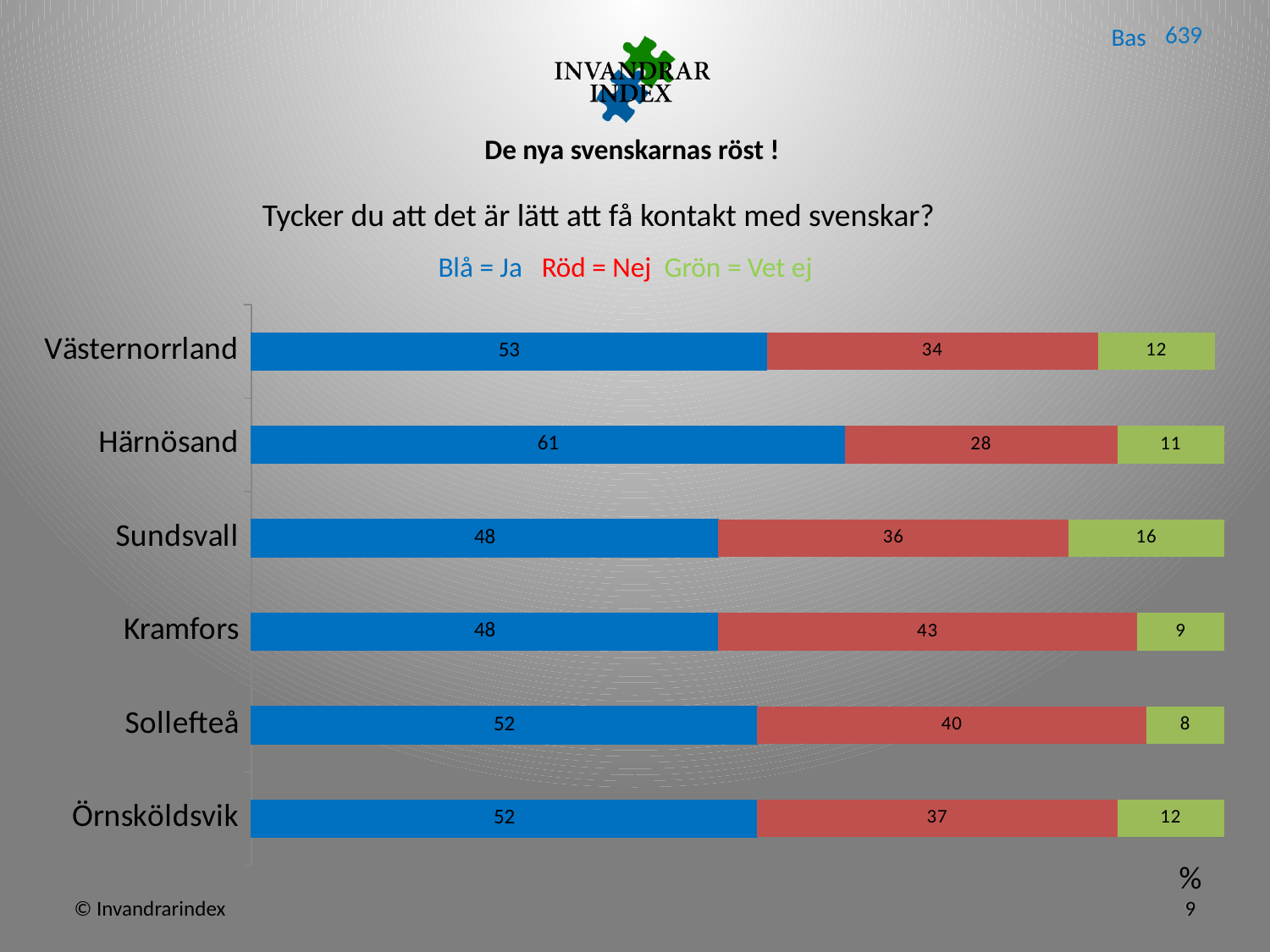
What is the total of the stacked bar for Örnsköldsvik? 101 What is the difference between the red (Nej) values for Kramfors and Härnösand? 15 According to the legend text, what does the red colour represent? Nej How many series does the chart show? 3 How many categories are shown on the chart? 6 Which is larger, the blue (Ja) value for Västernorrland or for Sundsvall? Västernorrland Which category has the highest blue (Ja) value? Härnösand What kind of chart is shown on the slide? Stacked bar chart What is the value of the green (Vet ej) segment for Sundsvall? 16 What is the value of the red (Nej) segment for Kramfors? 43 What is the value of the blue (Ja) segment for Härnösand? 61 Which category has the lowest green (Vet ej) value? Sollefteå